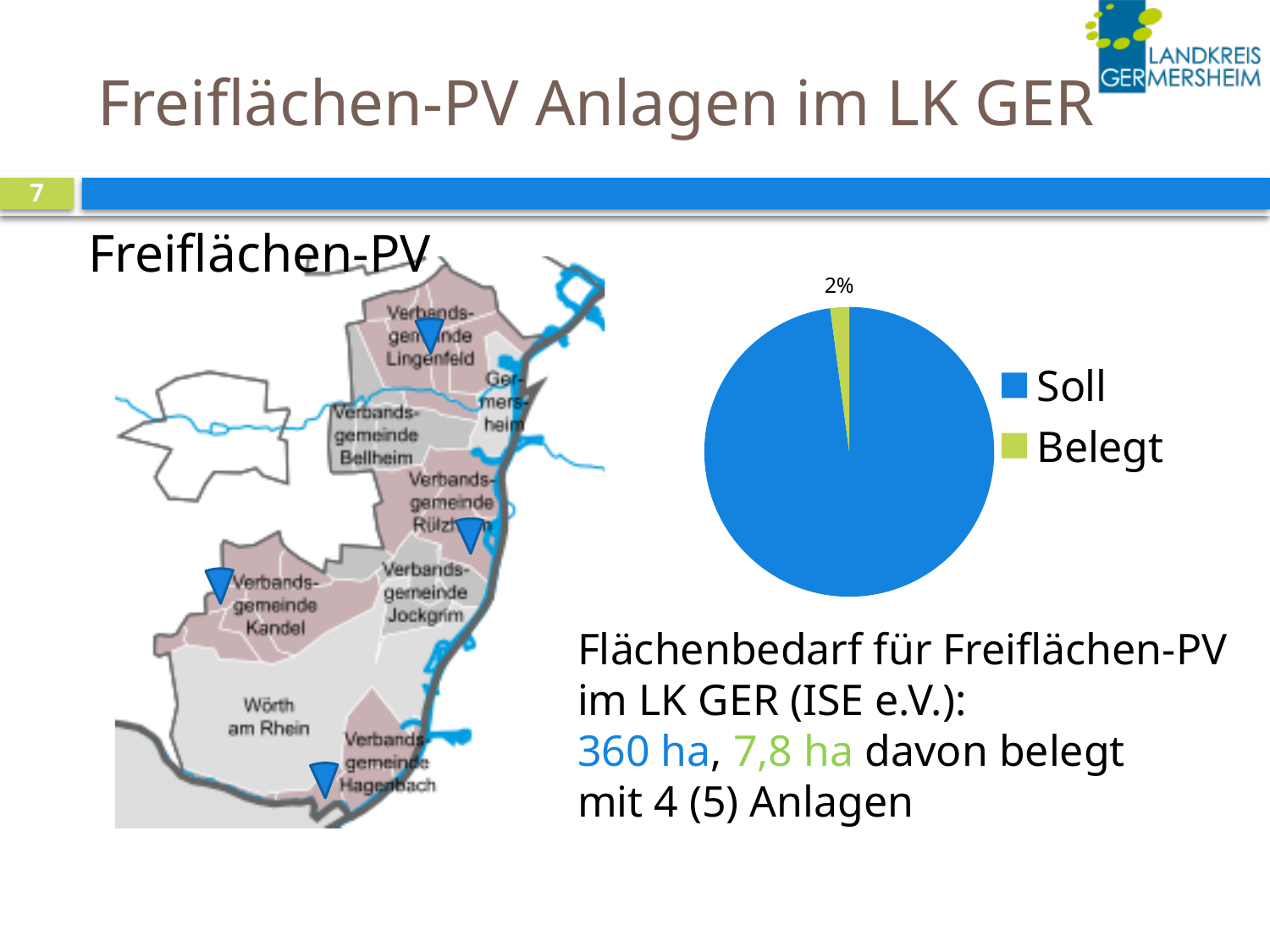
How many entries does the legend of the pie chart list? 2 What share of the pie chart does the Belegt slice represent? 2% Which is larger in the pie chart, Soll or Belegt? Soll Which slice of the pie chart is the smallest? Belegt What colour is the Belegt slice in the pie chart? green How many slices does the pie chart have? 2 What kind of chart is shown on the slide? pie chart What are the two legend entries of the pie chart? Soll, Belegt Which slice of the pie chart is the largest? Soll